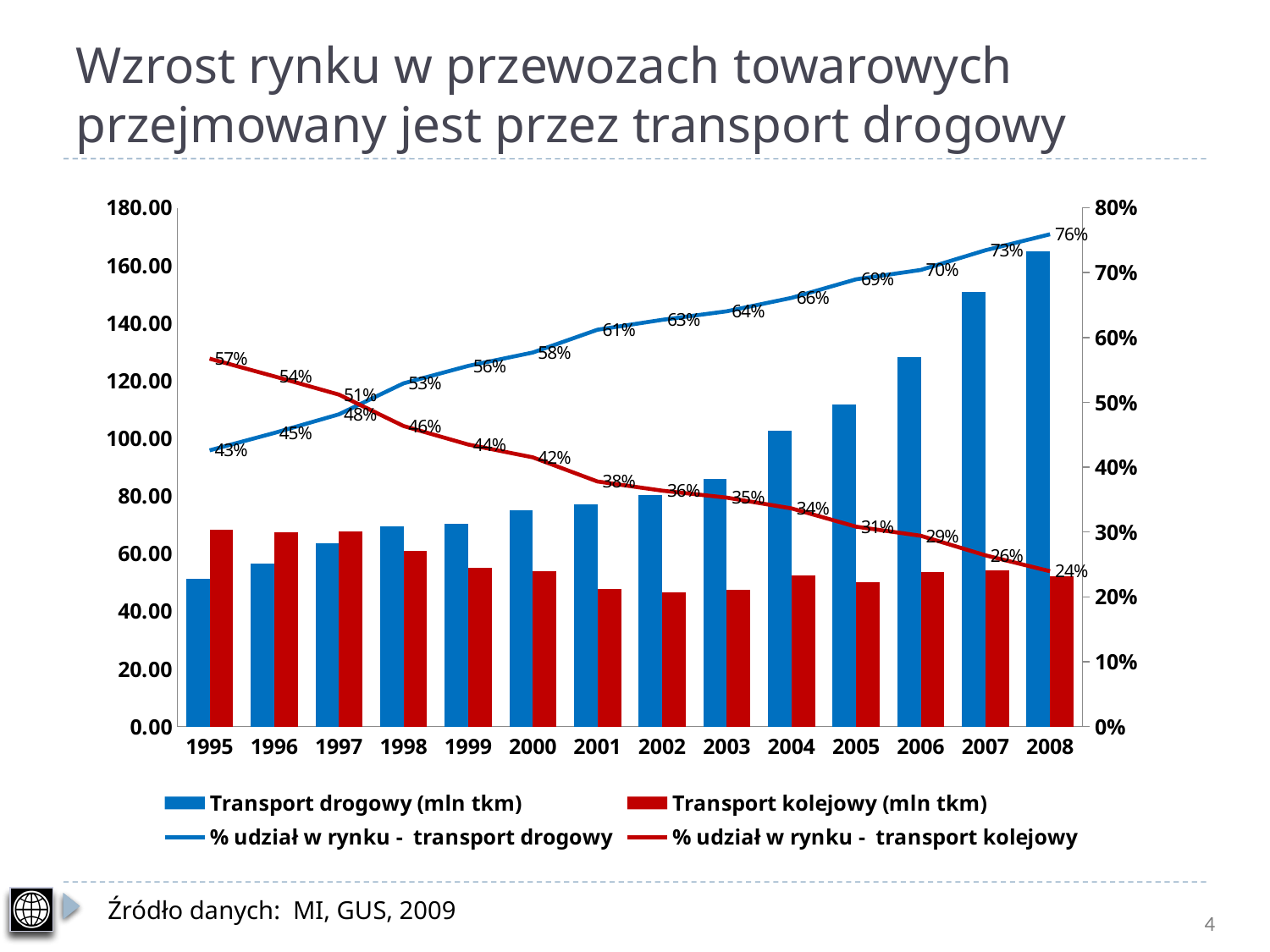
Is the value of Transport drogowy (mln tkm) in 2008 greater or less than 160.00? greater Which is larger in 1997: the road transport market share or the rail transport market share? Rail transport market share (51%) How many series does the legend list? 4 In which year is the road transport market share the lowest? 1995 What is the market share of rail transport (% udział w rynku - transport kolejowy) in 1995? 57% How many years are shown on the x axis of the chart? 14 Is the value of Transport kolejowy (mln tkm) in 2002 greater or less than 60.00? less Does the road transport market share rise or fall from 1995 to 2008? rise By how many percentage points did the road transport market share change between 1995 and 2008? 33 percentage points What is the market share of rail transport in 2001? 38% What is the market share of road transport (% udział w rynku - transport drogowy) in 2008? 76% In which year is the rail transport market share the lowest? 2008